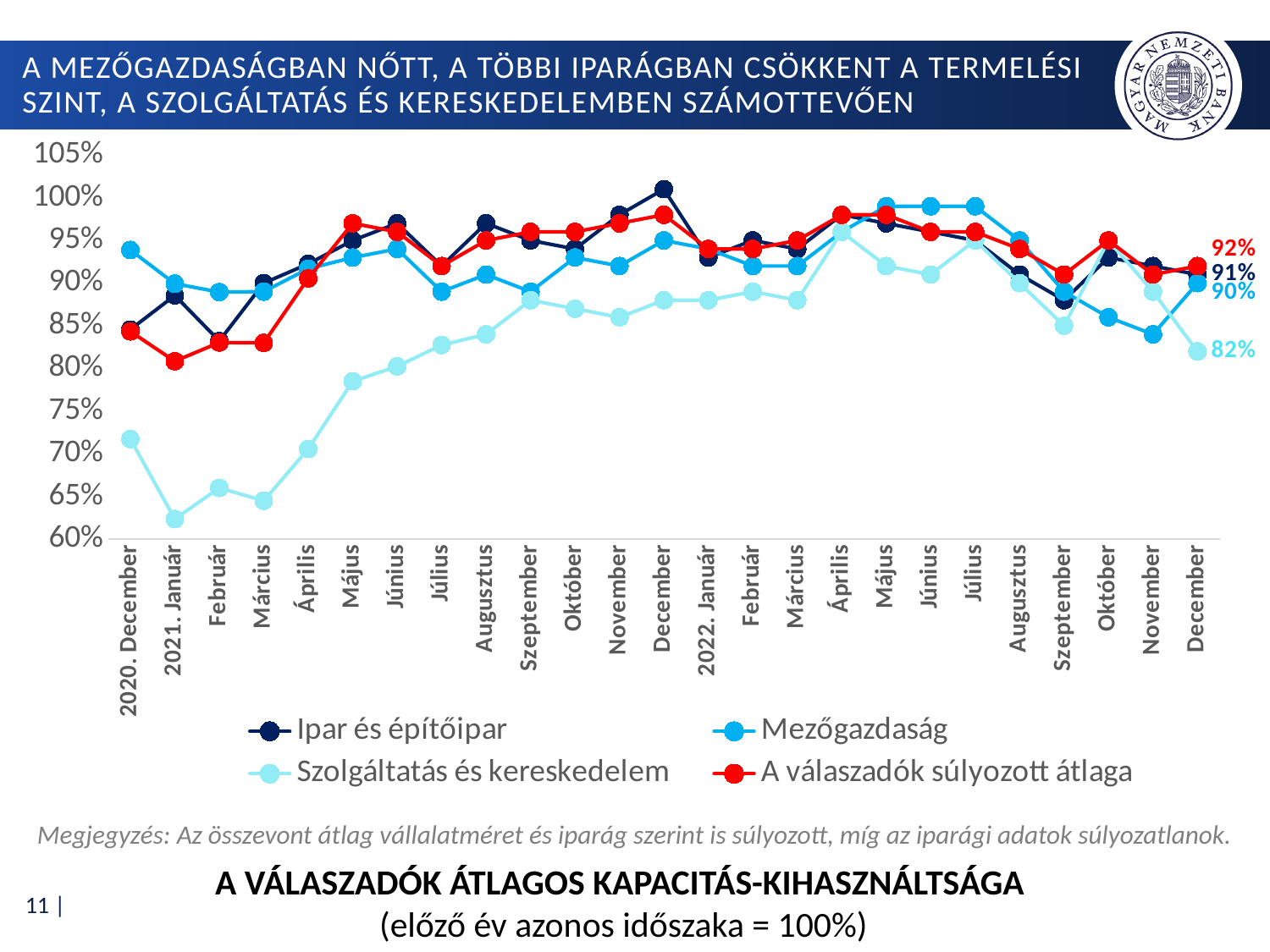
Which series has the highest value in December 2022? A válaszadók súlyozott átlaga What is the title of the chart? A válaszadók átlagos kapacitás-kihasználtsága Does the 'Szolgáltatás és kereskedelem' line rise or fall from 2021 Január to 2021 Május? rise What is the value for 'Ipar és építőipar' in December 2022? 91% What is the value for 'Szolgáltatás és kereskedelem' in December 2022? 82% How many monthly points are plotted along the x axis? 25 What type of chart is shown on the slide? line chart How many series does the legend list? 4 Is the value for 'Szolgáltatás és kereskedelem' in 2021 Január greater or less than 65%? less In December 2022, which is higher: 'Ipar és építőipar' or 'Szolgáltatás és kereskedelem'? Ipar és építőipar What is the difference between 'Ipar és építőipar' and 'Szolgáltatás és kereskedelem' in December 2022? 9 percentage points What is the value for 'A válaszadók súlyozott átlaga' in December 2022? 92%